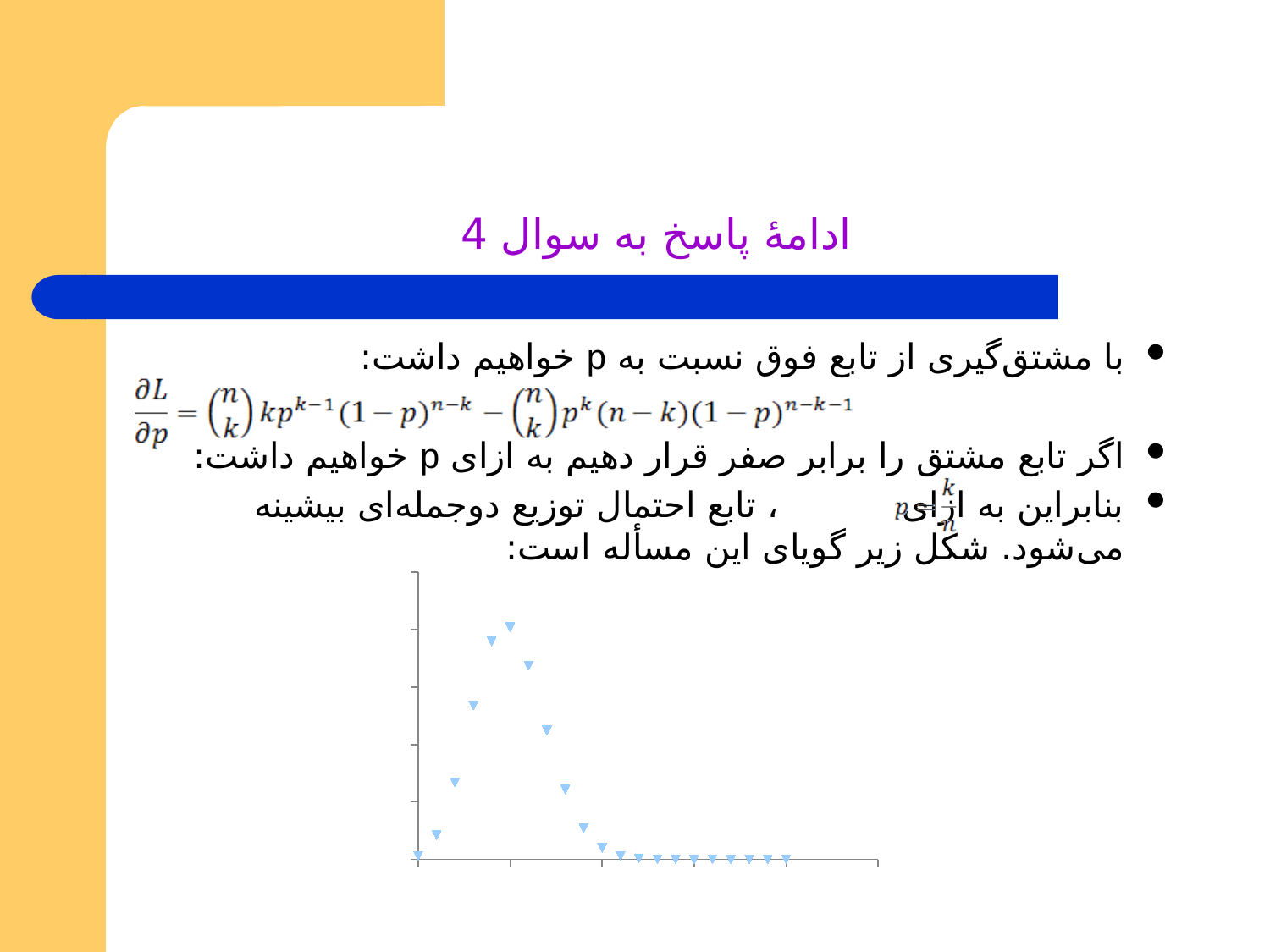
Do the plotted values rise or fall along the x axis after reaching their peak? fall Is the peak of the plotted points located in the left half or the right half of the x axis? left half What kind of chart is shown on the slide? scatter chart Does the chart show a legend? no What marker shape is used for the plotted points? triangles Do the plotted values rise or fall along the x axis before reaching their peak? rise